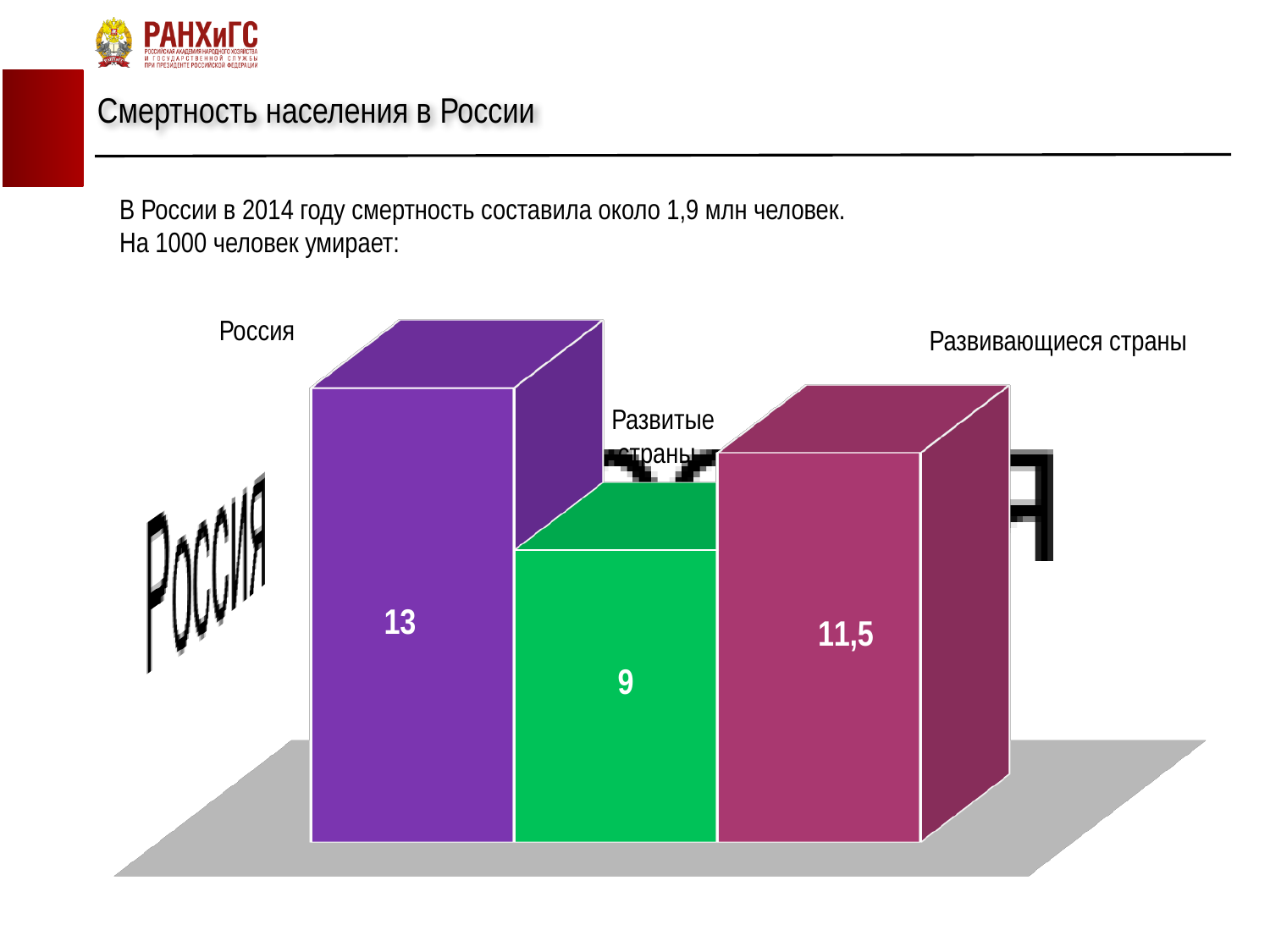
What is the difference between the values for Россия and Развивающиеся страны? 1,5 Which category has the lowest value? Развитые страны What kind of chart is shown on the slide? bar chart What is the value shown for Россия? 13 What colour is the bar for Развитые страны? green Which is larger, the value for Развивающиеся страны or the value for Развитые страны? Развивающиеся страны What is the value shown for Развитые страны? 9 What is the value shown for Развивающиеся страны? 11,5 What is the difference between the values for Россия and Развитые страны? 4 What is the title of the slide containing the chart? Смертность населения в России How many categories are shown in the chart? 3 Which category has the highest value? Россия